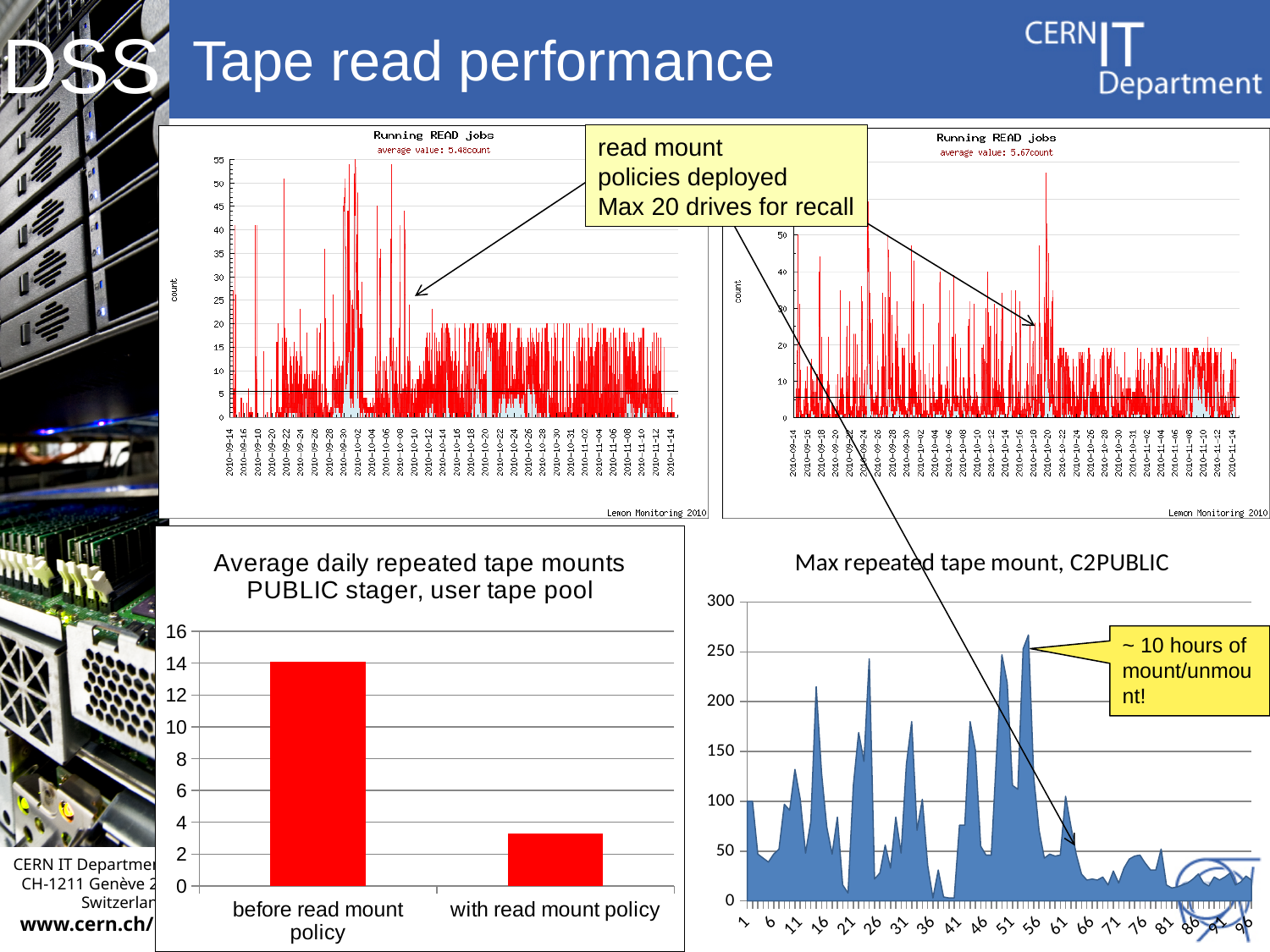
What average value is printed under the title of the top-right 'Running READ jobs' chart? 5.67count How many categories are shown in the bottom-left chart 'Average daily repeated tape mounts'? 2 In the bottom-left chart 'Average daily repeated tape mounts', is the value for 'with read mount policy' greater or less than 2? greater What average value is printed under the title of the top-left 'Running READ jobs' chart? 5.48count In the bottom-right chart 'Max repeated tape mount, C2PUBLIC', is the highest peak greater or less than 250? greater In the bottom-left chart 'Average daily repeated tape mounts', is the value for 'with read mount policy' greater or less than 4? less What is the title of the bottom-right chart on the slide? Max repeated tape mount, C2PUBLIC What kind of chart is the bottom-left chart 'Average daily repeated tape mounts'? bar chart In the bottom-right chart 'Max repeated tape mount, C2PUBLIC', do the values overall rise or fall from left to right along the x axis? fall In the bottom-left chart 'Average daily repeated tape mounts', which category has the lower value? with read mount policy In the bottom-left chart 'Average daily repeated tape mounts', which category has the higher value? before read mount policy